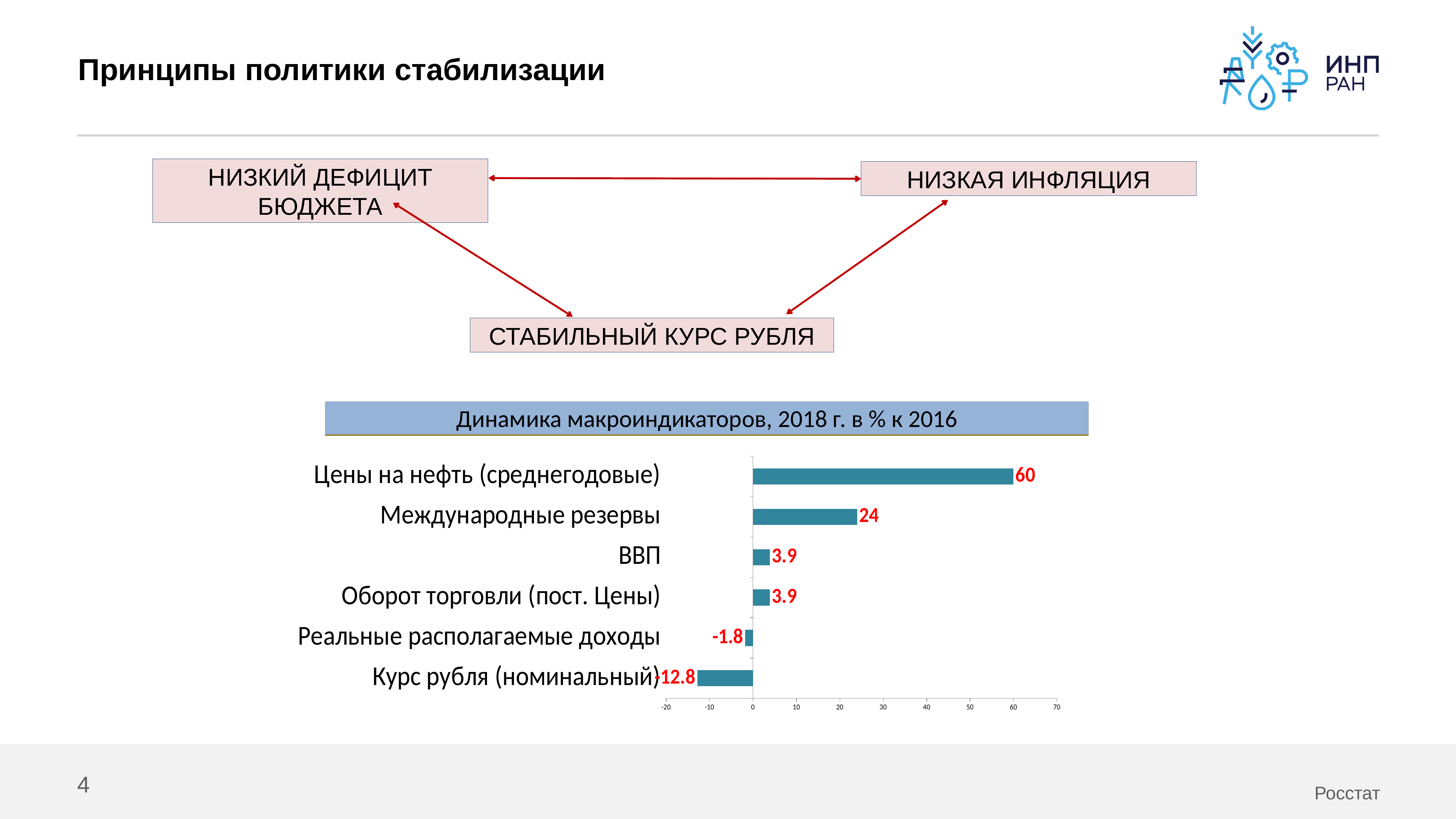
Which category has the lowest value? Курс рубля (номинальный) What kind of chart is shown on the slide? bar chart What is the difference between the values for Цены на нефть (среднегодовые) and Международные резервы? 36 Which is larger, the value for Международные резервы or the value for ВВП? Международные резервы What is the value for Курс рубля (номинальный)? -12.8 Which category has the highest value? Цены на нефть (среднегодовые) What is the title of the chart? Динамика макроиндикаторов, 2018 г. в % к 2016 Is the value for Цены на нефть (среднегодовые) greater or less than 50? greater How many categories are shown in the chart? 6 What is the value for Цены на нефть (среднегодовые)? 60 What is the value for Реальные располагаемые доходы? -1.8 What is the value for Международные резервы? 24